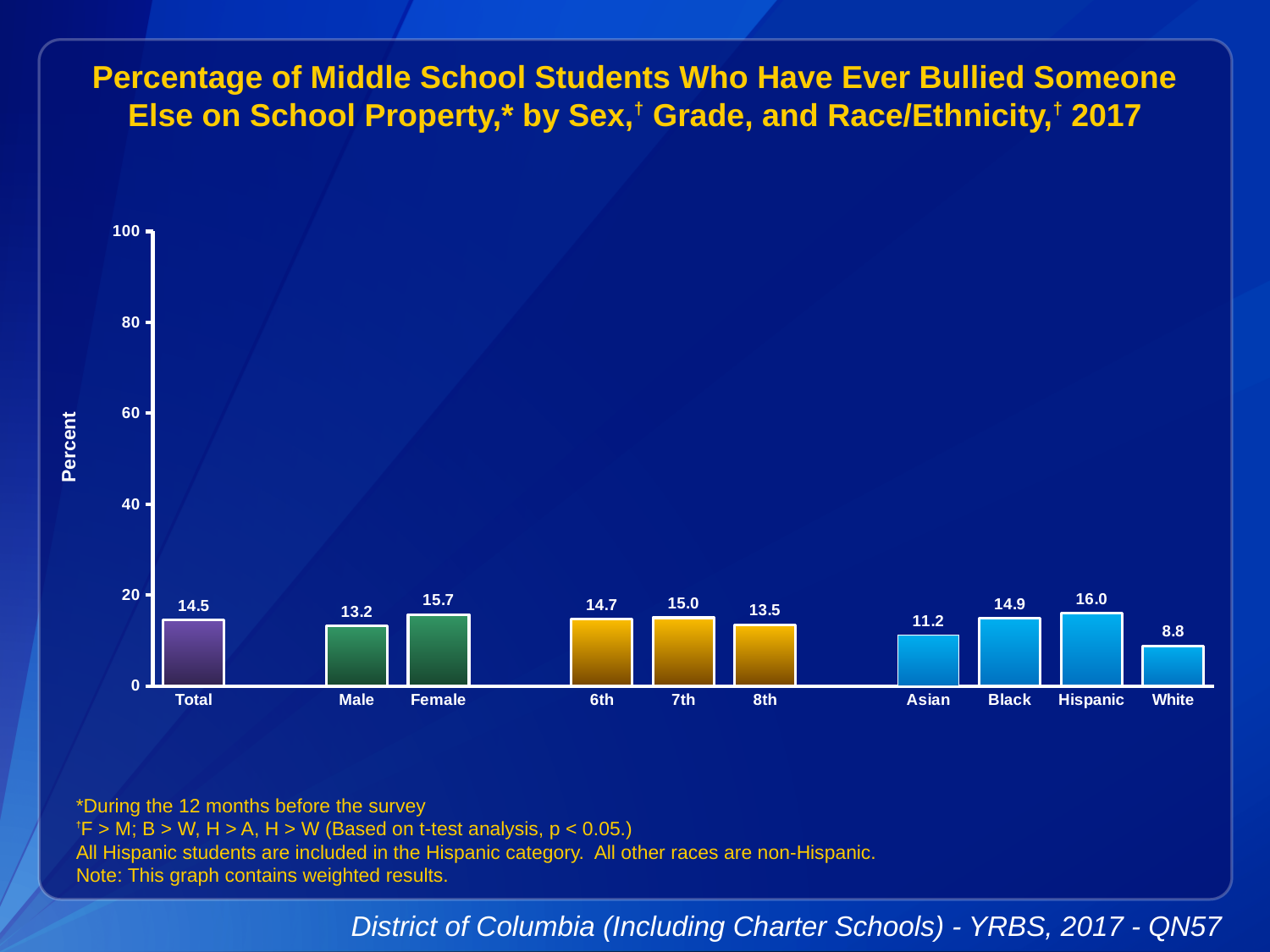
Which category has the highest value? Hispanic What kind of chart is this? bar chart What is the value for Female? 15.7 Which category has the lowest value? White What is the difference between the Female and Male values? 2.5 How many categories are shown on the x axis? 10 What is the value for Asian? 11.2 What is the difference between the Hispanic and White values? 7.2 Is the value for Black greater or less than 20? less What is the label of the y axis? Percent Which is larger, the value for 7th or the value for 8th? 7th What is the value for Total? 14.5